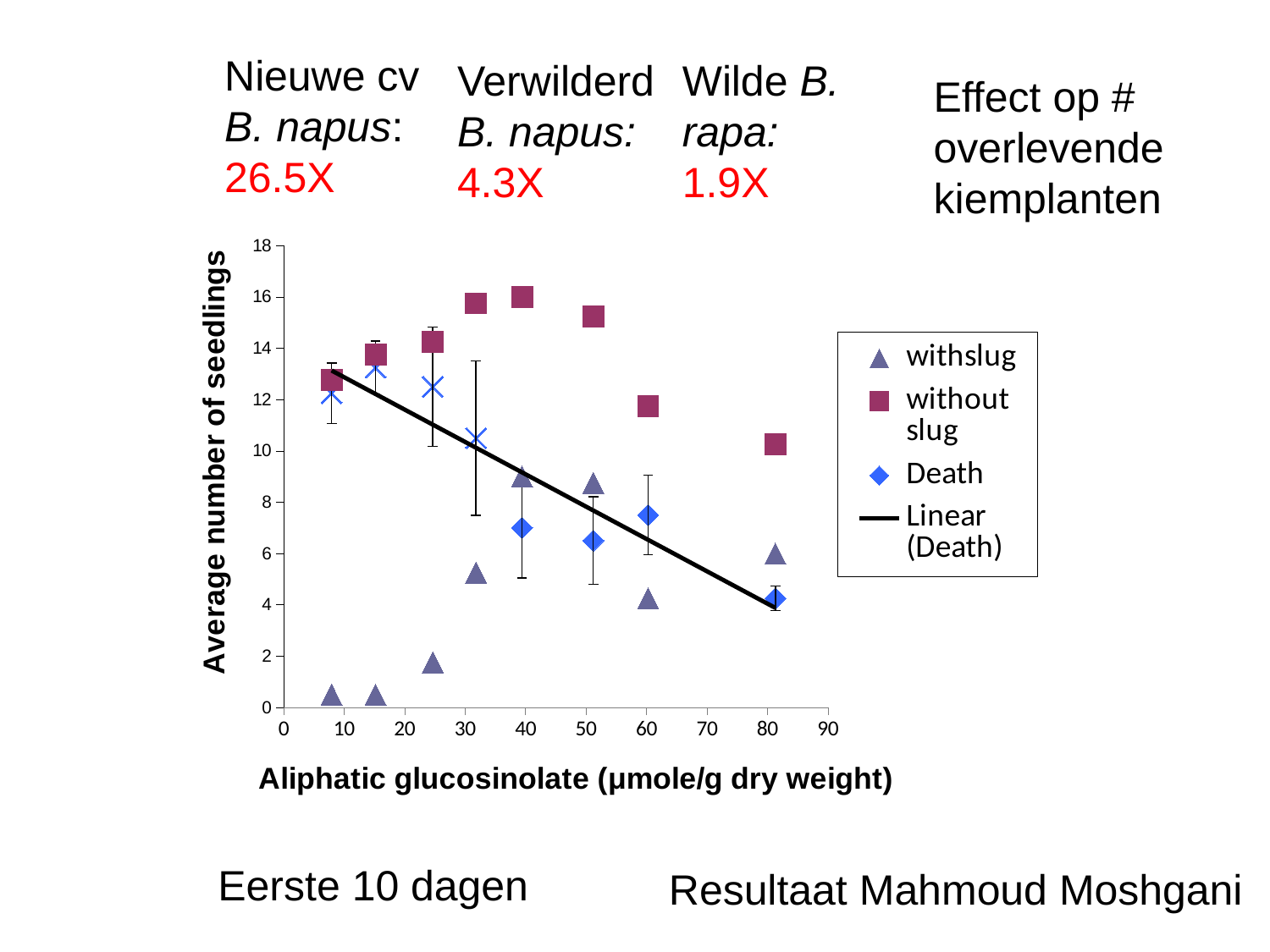
At about 40 µmole/g, which series has the larger value: 'withslug' or 'without slug'? without slug How many series does the chart legend list? 4 Is the 'withslug' value at about 8 µmole/g greater or less than 2? less What is the title of the y axis of the chart? Average number of seedlings Is the 'withslug' value at about 60 µmole/g greater or less than 6? less What kind of chart is shown on the slide? scatter chart How many 'without slug' data points are plotted on the chart? 8 Which series reaches the highest average number of seedlings on the chart? without slug Is the 'Death' value at about 81 µmole/g greater or less than 6? less What is the title of the x axis of the chart? Aliphatic glucosinolate (µmole/g dry weight) Does the Linear (Death) trend line rise or fall as aliphatic glucosinolate increases along the x axis? fall